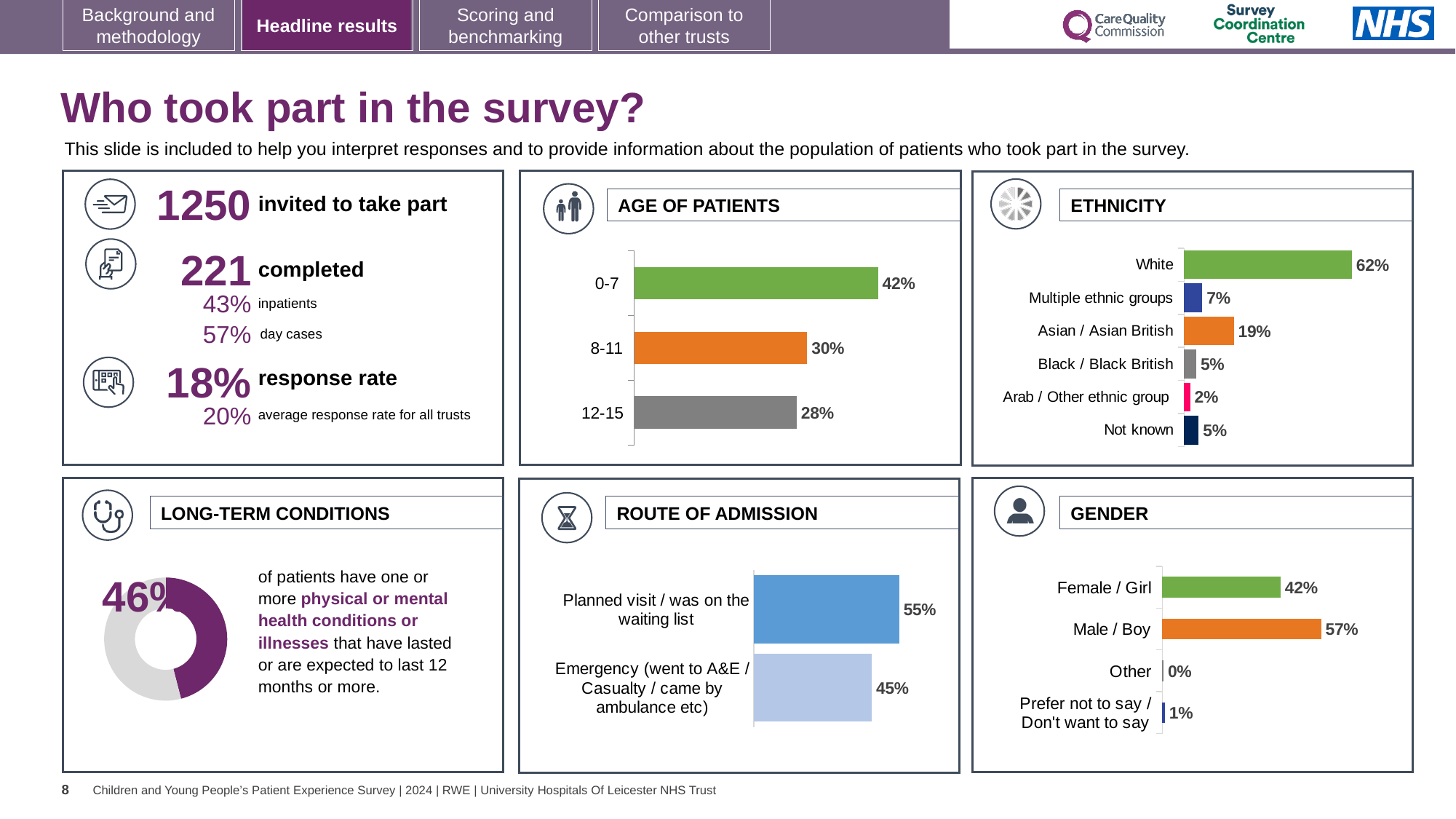
In the LONG-TERM CONDITIONS chart, what share of patients have one or more long-term conditions? 46% What kind of chart is used in the LONG-TERM CONDITIONS panel? Doughnut chart In the ROUTE OF ADMISSION chart, what percentage of patients came via Emergency (went to A&E / Casualty / came by ambulance etc)? 45% In the ROUTE OF ADMISSION chart, which route has the larger value: Planned visit / was on the waiting list or Emergency? Planned visit / was on the waiting list In the GENDER chart, what is the difference between Male / Boy and Female / Girl? 15% In the AGE OF PATIENTS chart, what percentage of patients were aged 0-7? 42% How many categories are shown in the ETHNICITY chart? 6 In the AGE OF PATIENTS chart, which age group has the lowest percentage? 12-15 In the ETHNICITY chart, what is the value for Asian / Asian British? 19% In the ETHNICITY chart, what is the difference between the White and Asian / Asian British values? 43% In the GENDER chart, what is the value for Male / Boy? 57% In the ETHNICITY chart, which category has the highest value? White